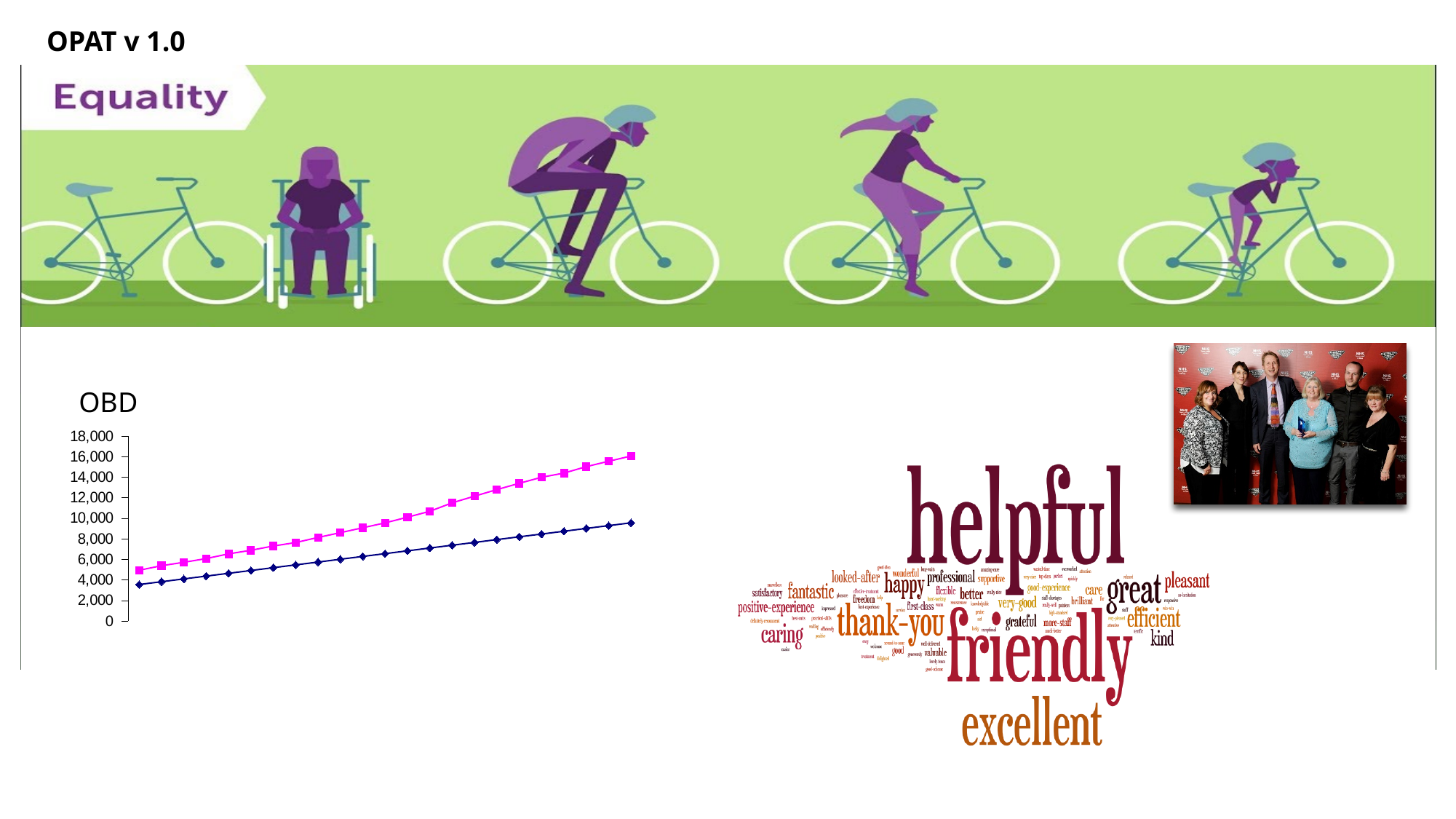
What is the title of the chart on the slide? OBD In the OBD chart, is the last value of the pink line greater or less than 14,000? greater Do the values of the pink line in the OBD chart rise or fall from left to right? rise Do the values of the blue line in the OBD chart rise or fall from left to right? rise What is the highest value shown on the y axis of the OBD chart? 18,000 In the OBD chart, is the first value of the pink line greater or less than 6,000? less How many lines are plotted in the OBD chart? 2 In the OBD chart, is the last value of the blue line greater or less than 10,000? less What kind of chart is shown under the title OBD? line chart In the OBD chart, which line ends higher at the right-hand side, the pink line or the blue line? the pink line